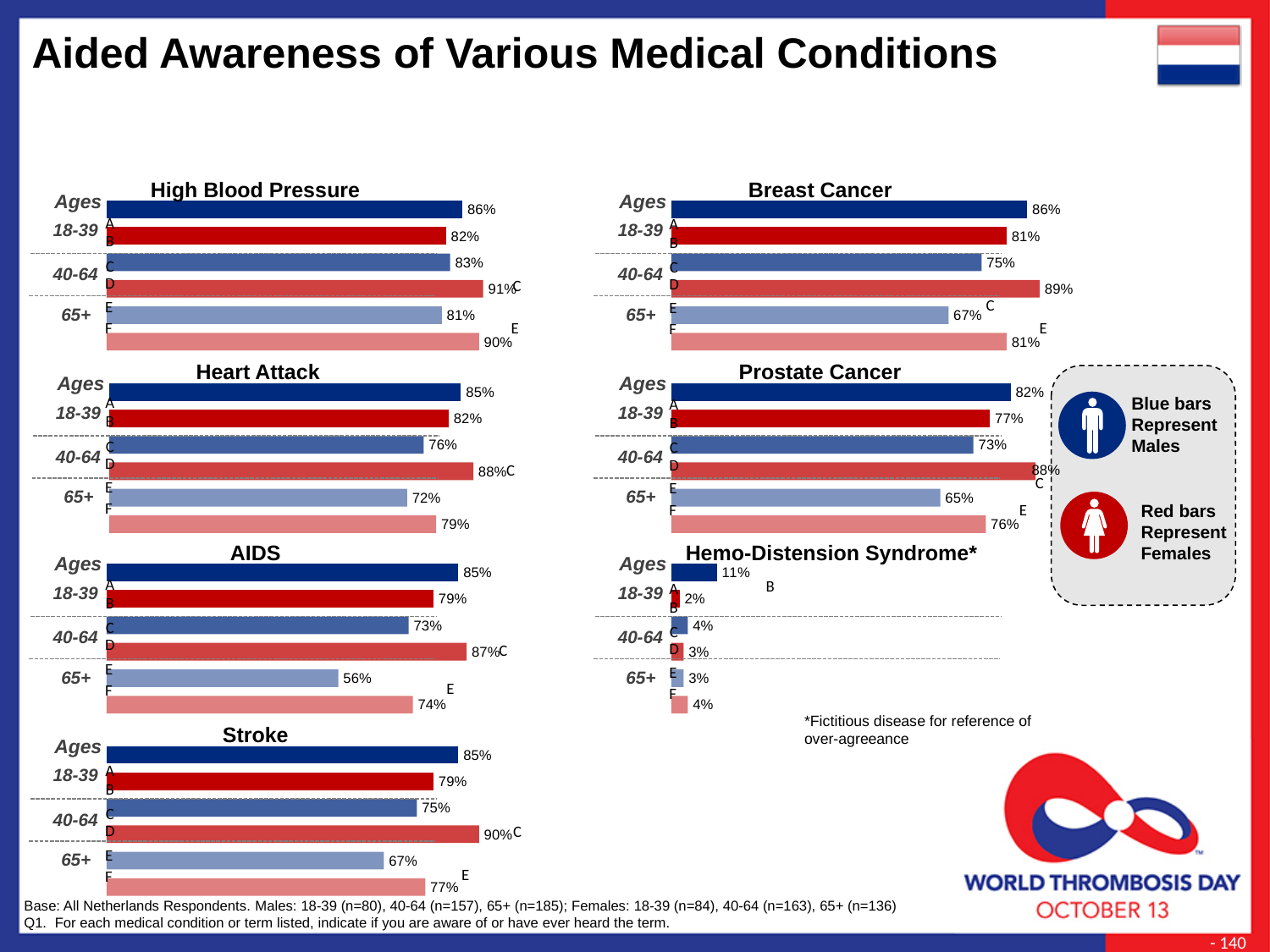
In the Breast Cancer chart, how does awareness among males change from ages 18-39 to 65+? It falls (86% to 75% to 67%) In the AIDS chart, what is the difference between females aged 65+ and males aged 65+? 18 percentage points In the Breast Cancer chart, what is the value for males aged 18-39? 86% In the Stroke chart, which age/gender group has the highest awareness? Females 40-64 (90%) In the High Blood Pressure chart, what is the value for females aged 40-64? 91% How many bars does the Stroke chart show? 6 According to the legend, what do the red bars represent? Females In the Heart Attack chart, what is the difference between females aged 40-64 and males aged 40-64? 12 percentage points What type of chart is used for Breast Cancer? Bar chart In the AIDS chart, what is the value for males aged 65+? 56% In the Prostate Cancer chart, which age/gender group has the lowest awareness? Males 65+ (65%) In the Hemo-Distension Syndrome chart, which is larger: males aged 18-39 or females aged 18-39? Males 18-39 (11%)